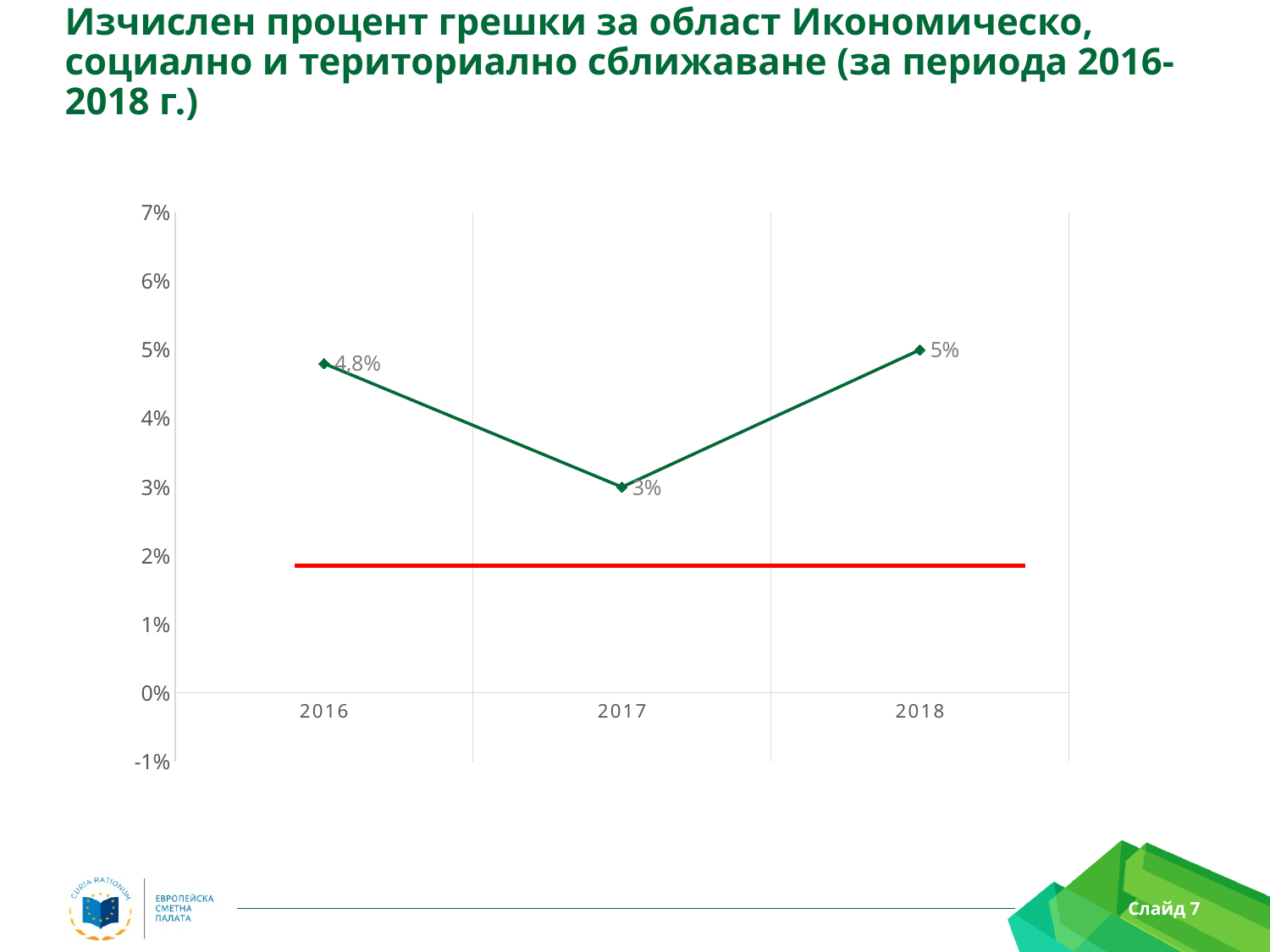
What kind of chart is shown on the slide? line chart What is the difference between the error rate in 2016 and the error rate in 2017? 1.8% What is the estimated error rate for 2016? 4.8% What is the estimated error rate for 2018? 5% What is the difference between the error rate in 2018 and the error rate in 2017? 2% Does the error rate rise or fall from 2017 to 2018? rise Which year has the highest estimated error rate? 2018 Which year has a higher error rate, 2016 or 2017? 2016 Is the value for 2017 greater or less than 2%? greater How many years are plotted on the chart? 3 What is the estimated error rate for 2017? 3% Which year has the lowest estimated error rate? 2017